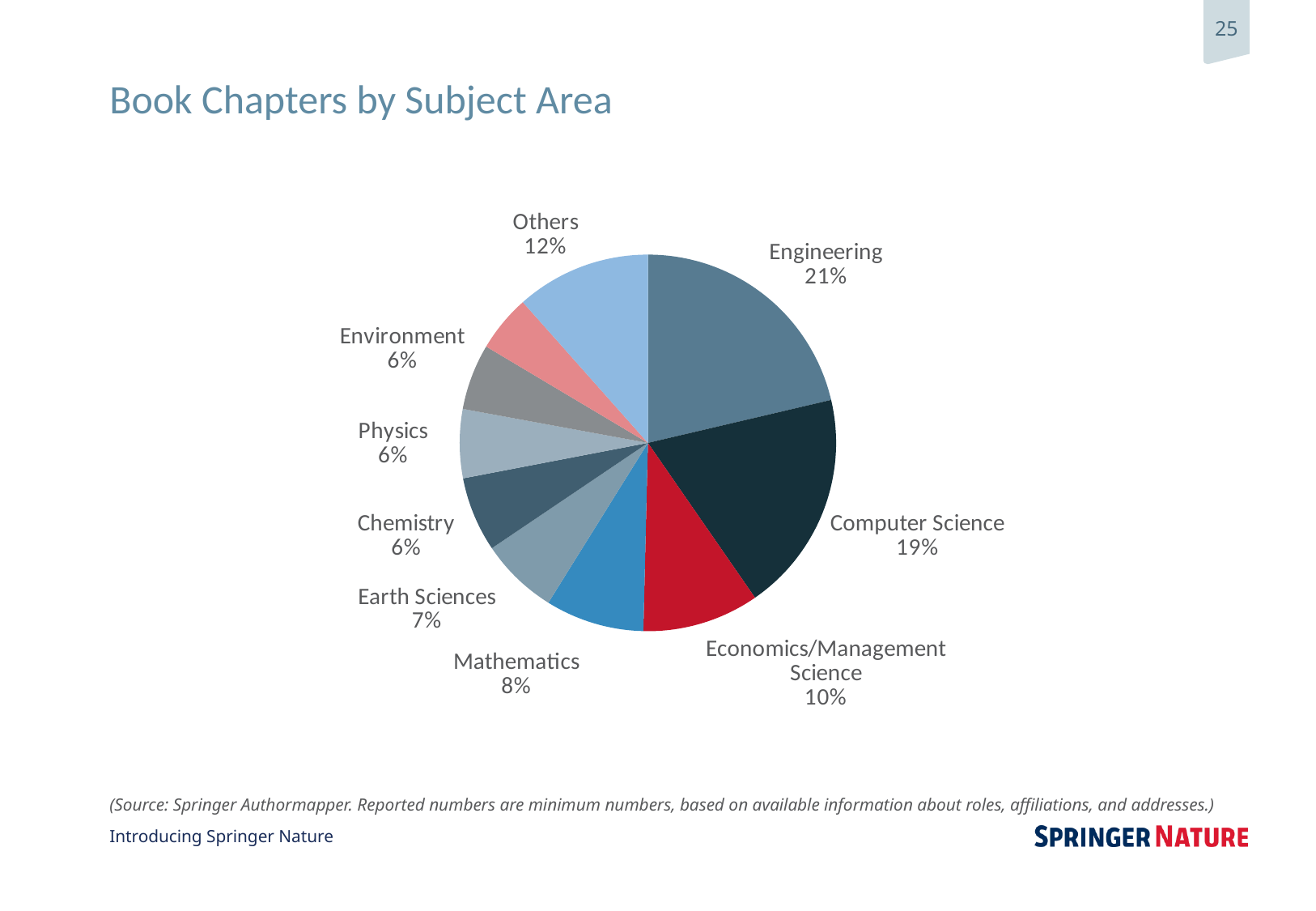
What is the combined share of Engineering and Computer Science? 40% What type of chart is shown on the slide? Pie chart What is the difference in percentage points between Engineering and Computer Science? 2 Which subject area has the largest share of book chapters? Engineering What percentage is shown for Mathematics? 8% What share of book chapters is in Engineering? 21% What percentage is shown for Earth Sciences? 7% Which has a larger share, Earth Sciences or Mathematics? Mathematics What share of book chapters is in Computer Science? 19% What is the title of the chart? Book Chapters by Subject Area What percentage is shown for Others? 12% What percentage is shown for Economics/Management Science? 10%